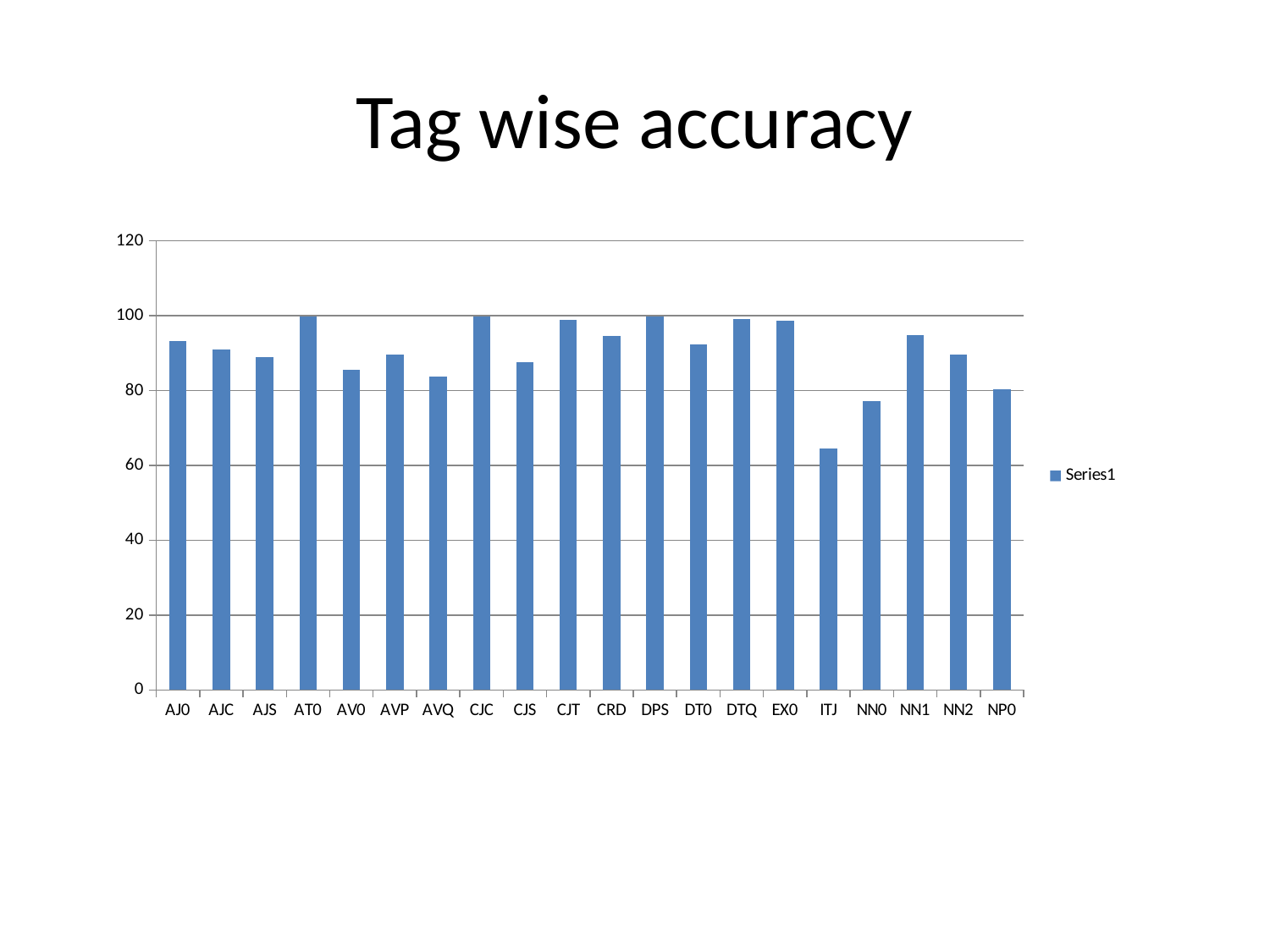
What is the title of the chart? Tag wise accuracy What kind of chart is shown on the slide? bar chart Which category has the lowest value? ITJ Is the value for ITJ greater or less than 80? less Which is larger, the value for AJ0 or the value for AV0? AJ0 Which is larger, the value for ITJ or the value for NN0? NN0 Which is larger, the value for CJS or the value for CJT? CJT What is the name of the series shown in the legend? Series1 How many series does the legend list? 1 Is the value for NN0 greater or less than 60? greater Is the value for AJ0 greater or less than 80? greater How many categories are shown on the x axis? 20